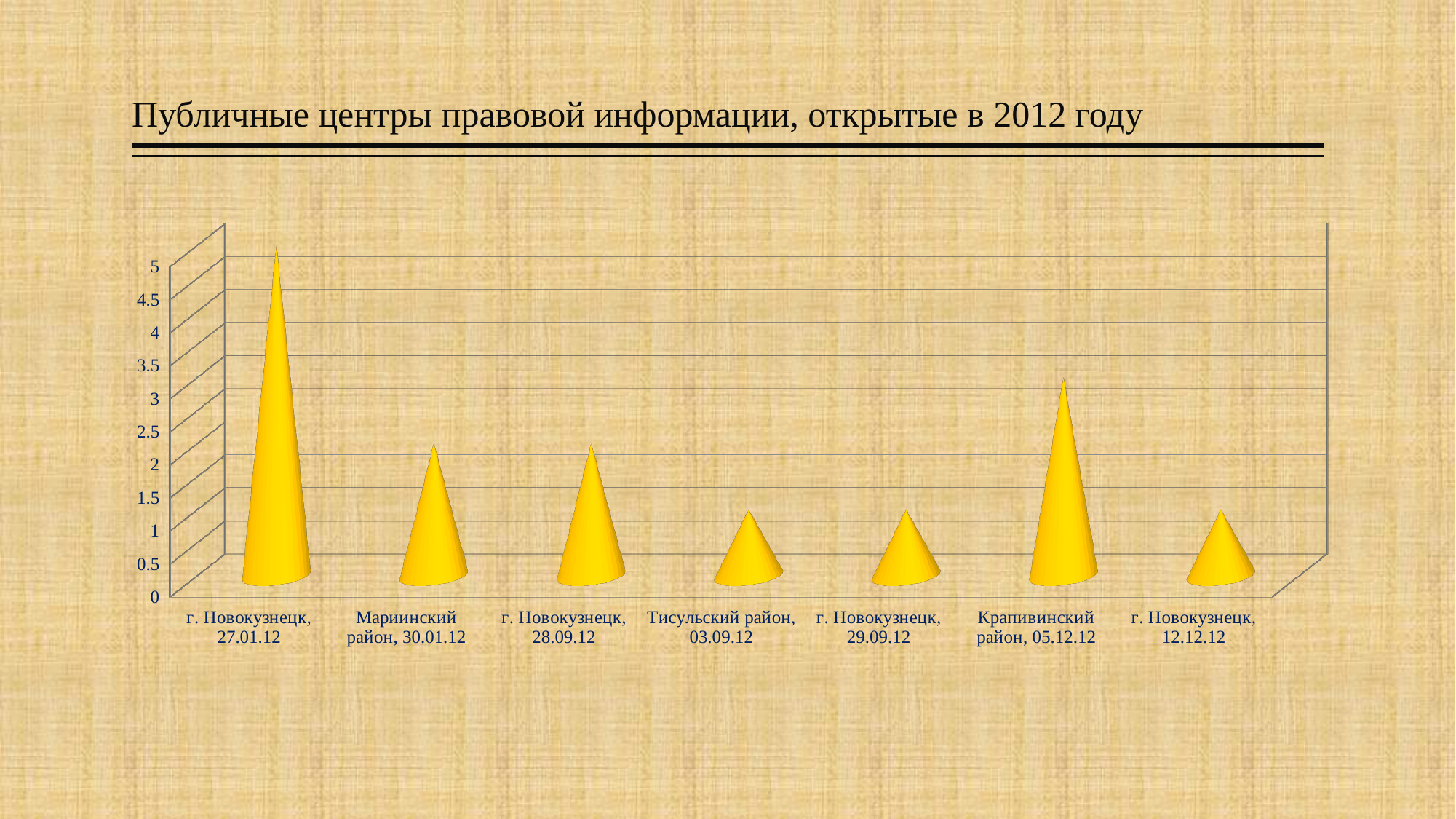
What is the title of the chart? Публичные центры правовой информации, открытые в 2012 году Which category has the highest value in the chart? г. Новокузнецк, 27.01.12 What colour are the bars in the chart? yellow Is the value for г. Новокузнецк, 12.12.12 greater or less than 2? less Which is larger: the value for Крапивинский район, 05.12.12 or the value for Мариинский район, 30.01.12? Крапивинский район, 05.12.12 Is the value for Тисульский район, 03.09.12 greater or less than 1.5? less Is the value for Крапивинский район, 05.12.12 greater or less than 2.5? greater How many categories are shown on the x axis of the chart? 7 Which is larger: the value for г. Новокузнецк, 28.09.12 or the value for г. Новокузнецк, 29.09.12? г. Новокузнецк, 28.09.12 What kind of chart is shown on the slide? bar chart